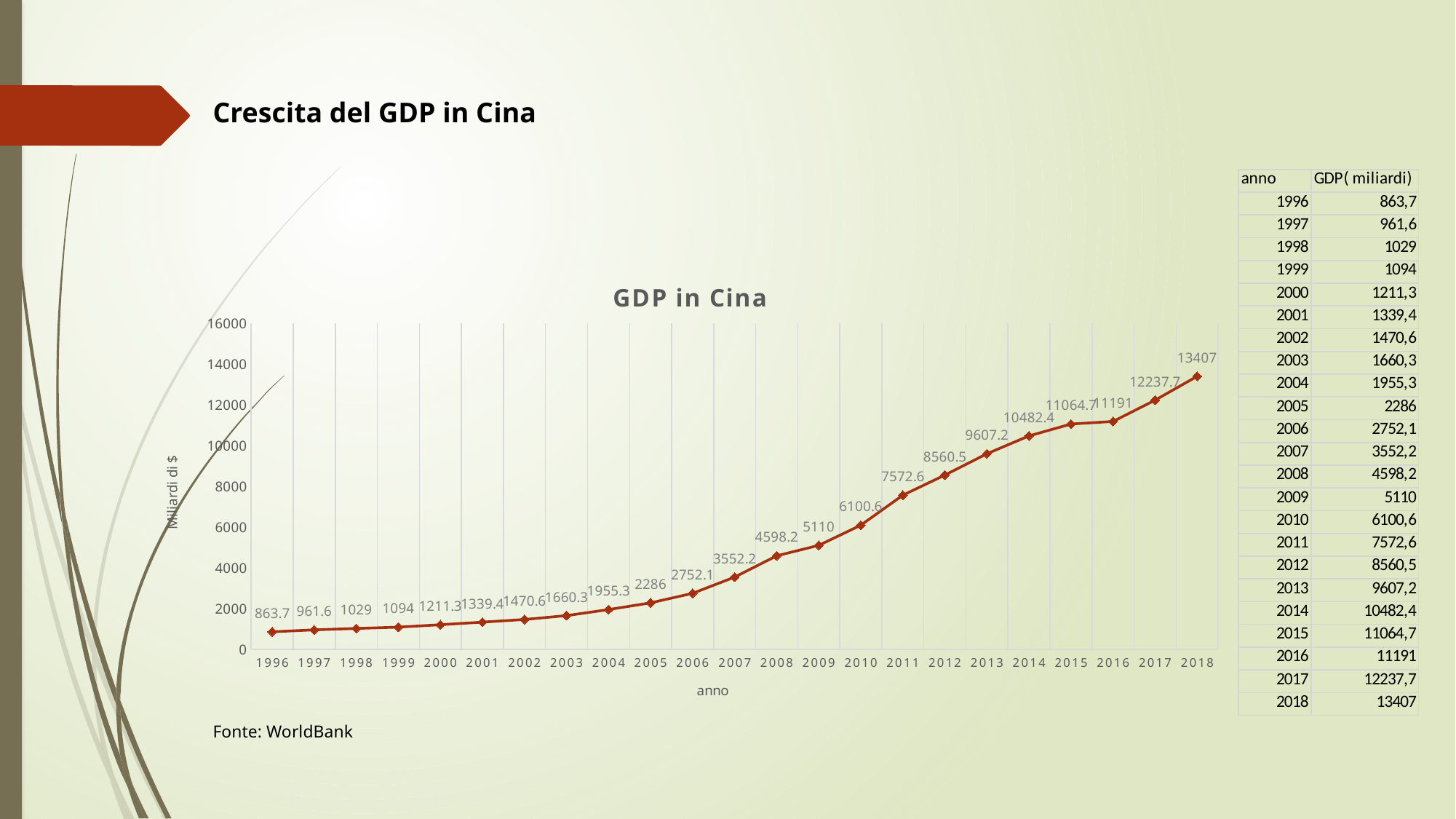
What is the difference between the GDP values for 2018 and 2017? 1169.3 Do the GDP values rise or fall from 1996 to 2018? rise Is the GDP value for 2014 greater or less than 10000? greater What is the GDP value plotted for 1996? 863.7 Which year has the lowest GDP value in the chart? 1996 How many years are plotted on the x axis of the chart? 23 What is the title of the chart? GDP in Cina What is the GDP value plotted for 2010? 6100.6 Which year has a larger GDP value, 2008 or 2009? 2009 What kind of chart is shown on the slide? line chart Which year has the highest GDP value in the chart? 2018 What is the GDP value plotted for 2018? 13407